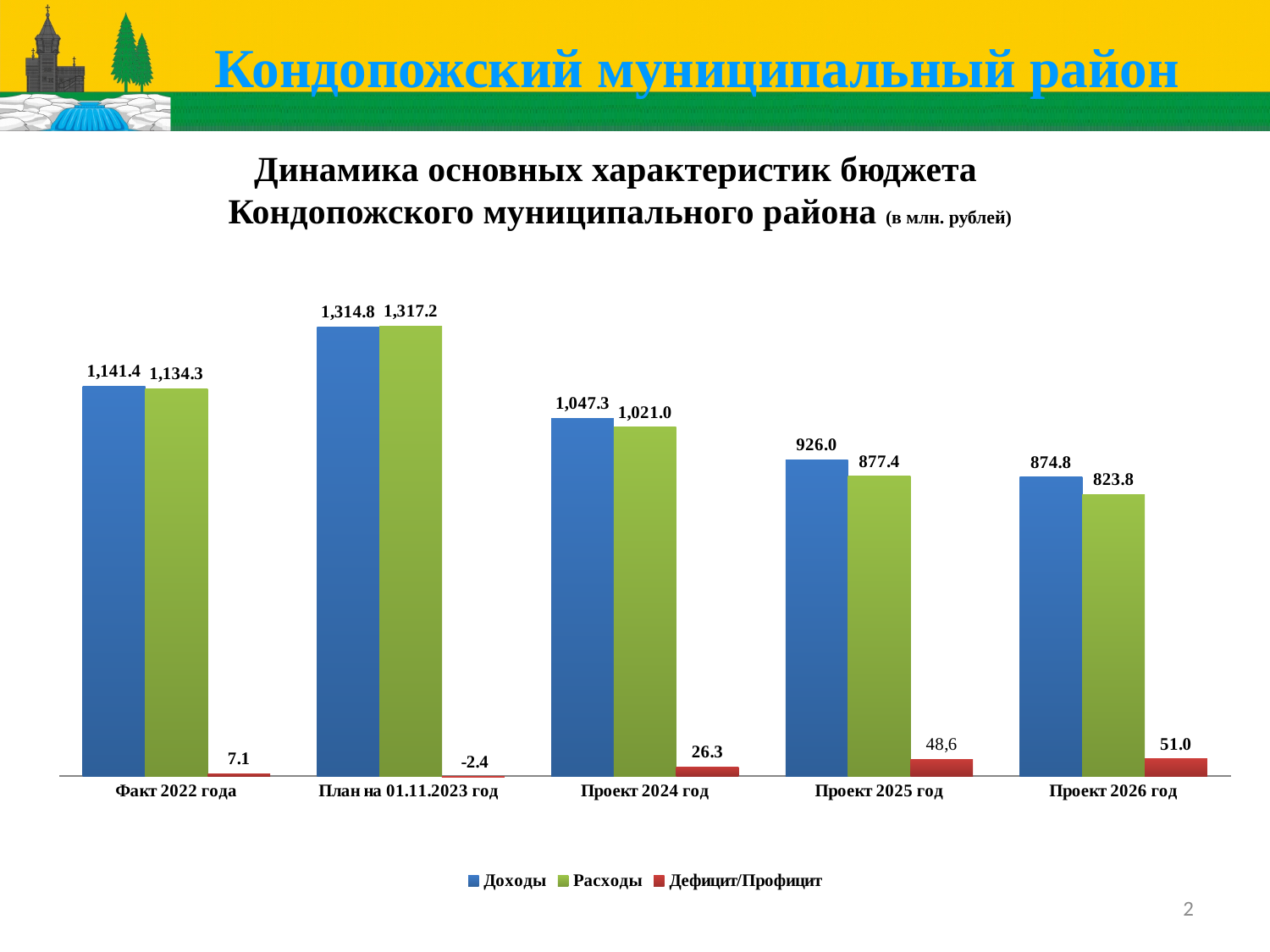
How many categories are shown on the x axis? 5 What is the value of Дефицит/Профицит for Проект 2025 год? 48,6 What is the value of Доходы for Проект 2024 год? 1,047.3 Which is larger for Факт 2022 года: Доходы or Расходы? Доходы How many series does the legend list? 3 What is the difference between Доходы for План на 01.11.2023 год and Доходы for Факт 2022 года? 173.4 What is the value of Расходы for План на 01.11.2023 год? 1,317.2 Which category has the highest value for Доходы? План на 01.11.2023 год Do the values for Доходы rise or fall from Проект 2024 год to Проект 2026 год? fall What is the difference between Доходы and Расходы for Проект 2024 год? 26.3 Which category has the lowest value for Дефицит/Профицит? План на 01.11.2023 год Which category has the lowest value for Расходы? Проект 2026 год